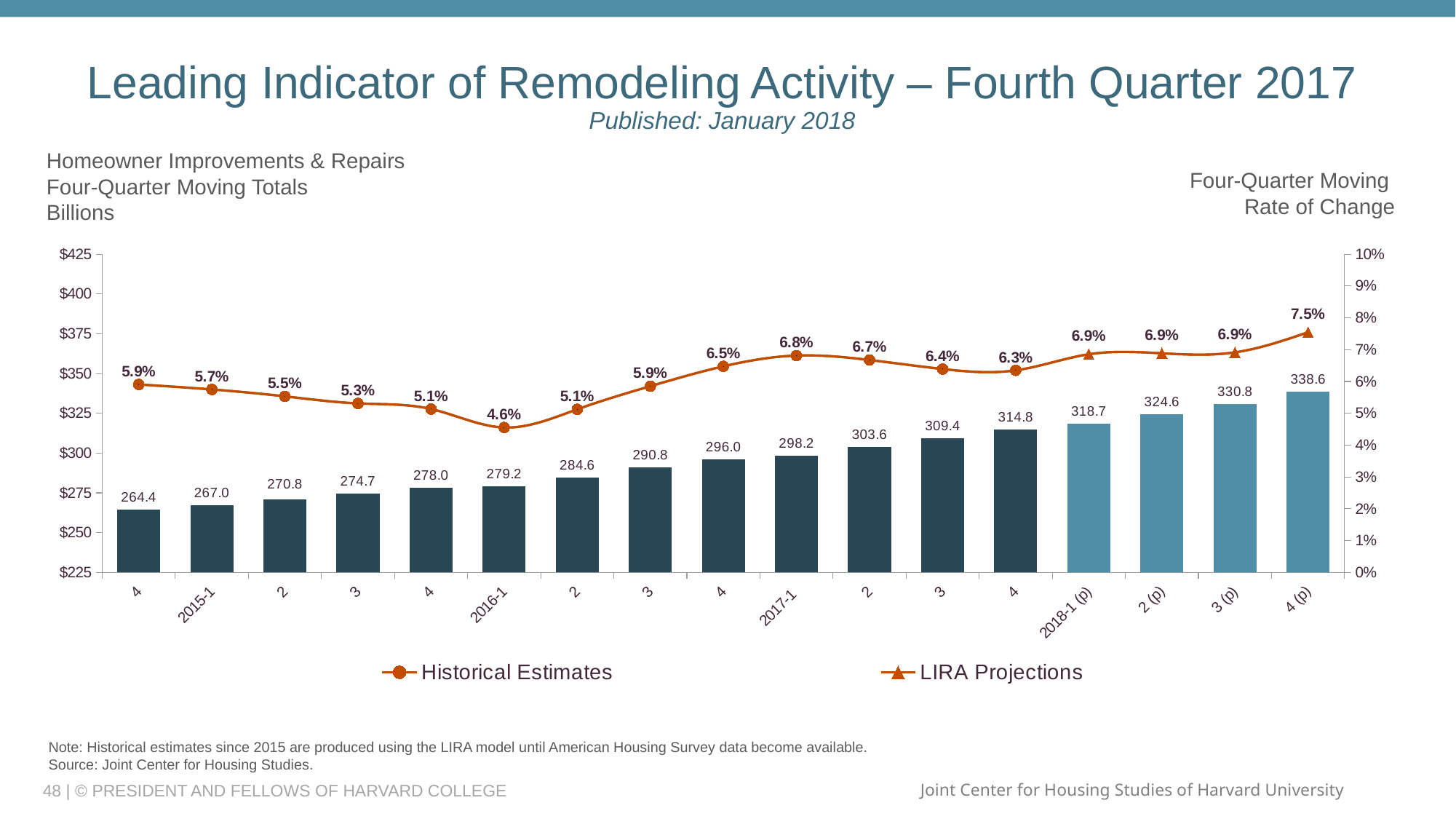
How many bars (quarters) are plotted in the chart? 17 Do the four-quarter moving totals (bars) rise or fall from left to right across the quarters? Rise What four-quarter moving rate of change is labeled for 2016-1? 4.6% Which has the higher rate of change, 2017-2 or 2017-3? 2017-2 (6.7%) What are the two series named in the legend? Historical Estimates and LIRA Projections How many series does the legend list? 2 What kind of chart is shown on the slide? A combined bar and line chart Which quarter has the lowest four-quarter moving rate of change on the line? 2016-1, at 4.6% What is the difference between the four-quarter moving total for 4 (p) of 2018 (338.6) and the first bar (264.4)? 74.2 Which quarter has the highest four-quarter moving rate of change on the line? 4 (p) of 2018, at 7.5% What is the four-quarter moving total shown for the 2018-1 (p) bar? 318.7 What is the four-quarter moving total (in billions) shown for 2017-1? 298.2